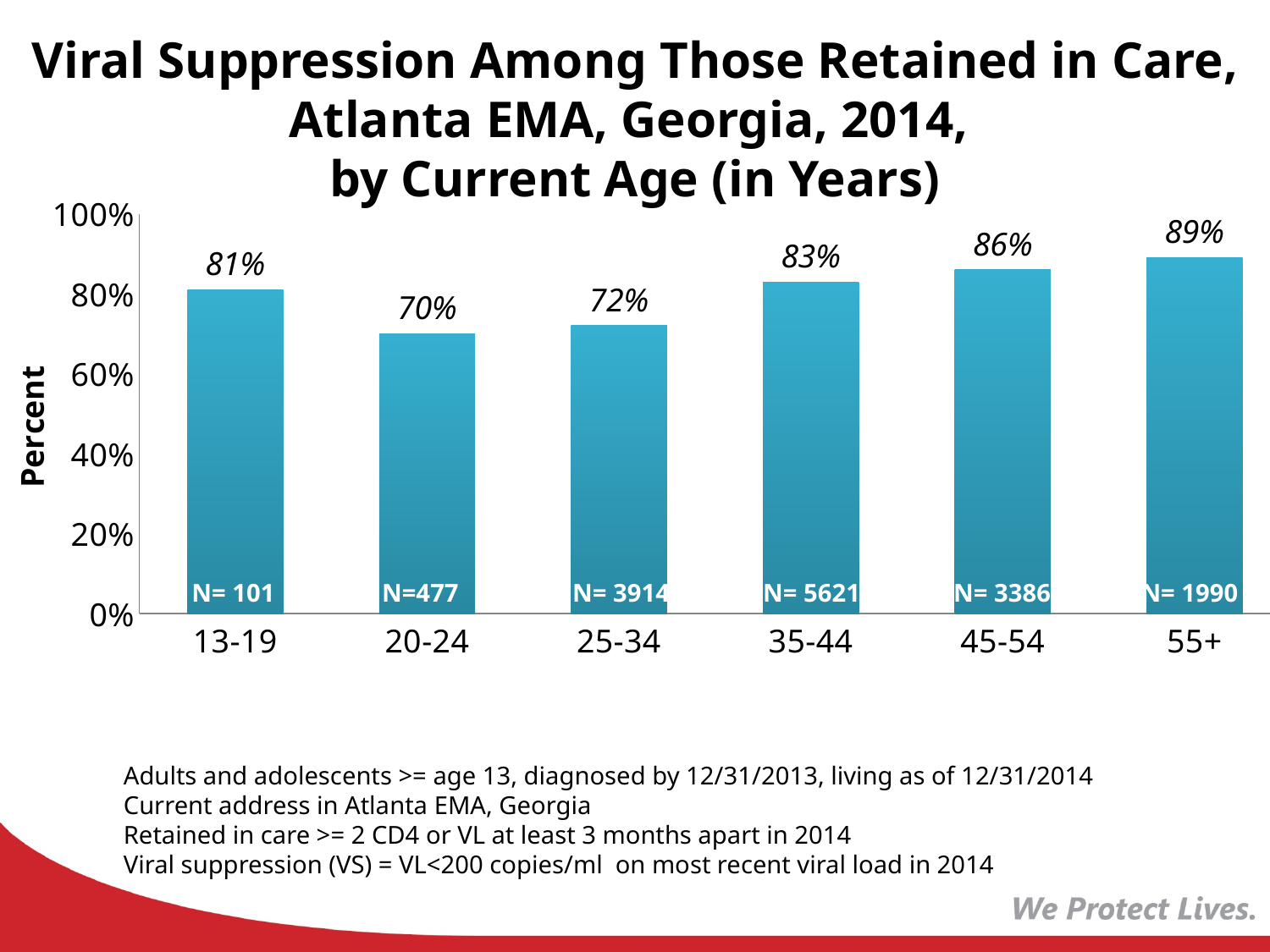
What is the label on the vertical axis of the chart? Percent What is the viral suppression percentage for the 13-19 age group? 81% From the 20-24 age group to the 55+ age group, do the viral suppression percentages rise or fall? Rise Is the value for the 20-24 age group greater or less than 80%? less What is the viral suppression percentage for the 35-44 age group? 83% What kind of chart is shown on the slide? Bar chart How many age groups are shown on the chart? 6 Which age group has the highest viral suppression percentage? 55+ Which age group has a higher viral suppression percentage, 25-34 or 45-54? 45-54 What is the difference in viral suppression percentage between the 55+ and 20-24 age groups? 19% What is the N value shown for the 45-54 age group? N= 3386 Which age group has the lowest viral suppression percentage? 20-24